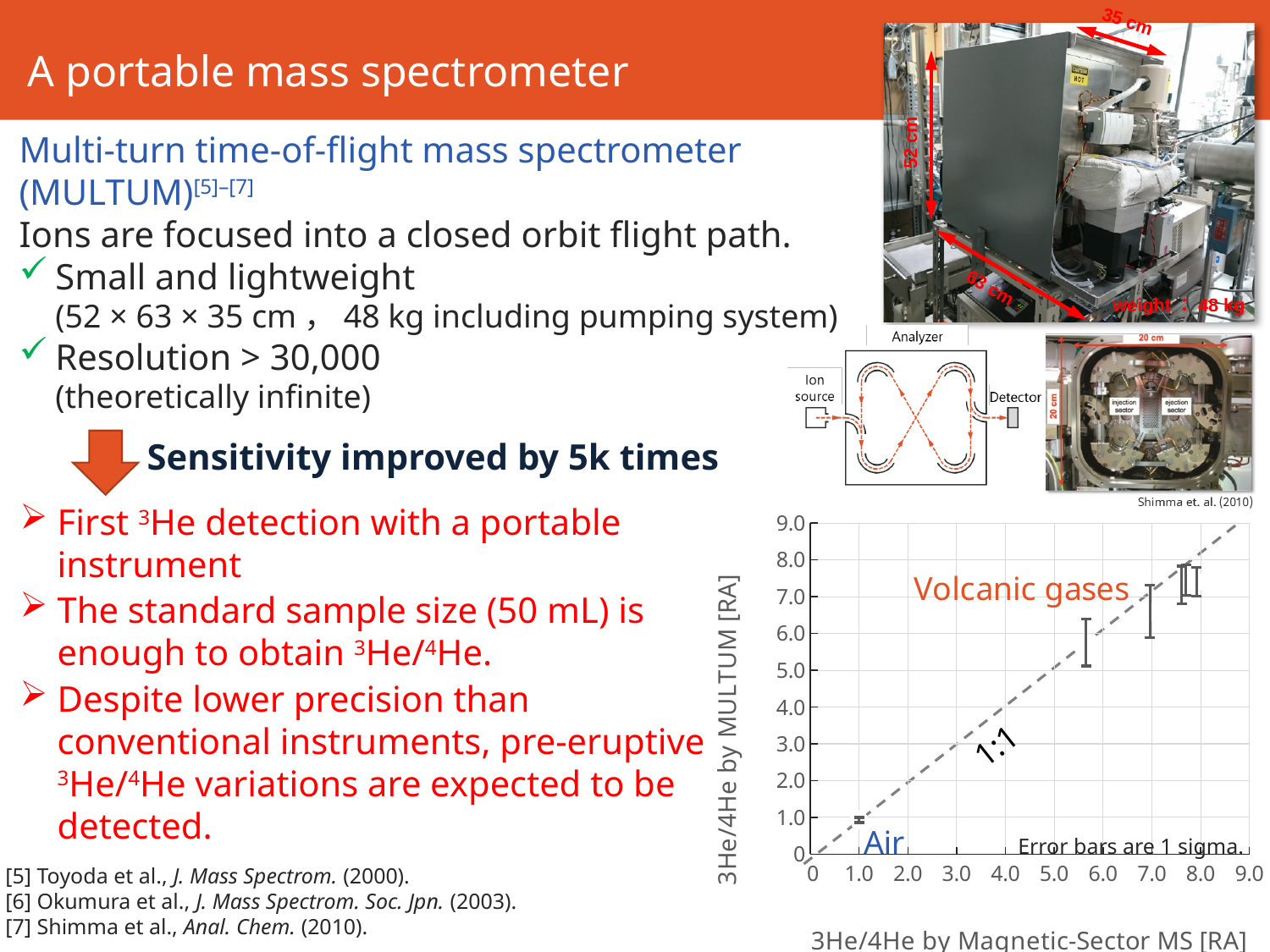
Which sample group has the higher 3He/4He values, Air or Volcanic gases? Volcanic gases What kind of chart is shown at the bottom right of the slide? scatter chart What is the label of the x axis of the chart? 3He/4He by Magnetic-Sector MS [RA] Do the MULTUM values rise or fall as the Magnetic-Sector MS values increase along the x axis? rise Are the Magnetic-Sector MS values for the volcanic gas samples greater or less than 4.0? greater Are the MULTUM values for the volcanic gas samples greater or less than 5.0? greater What is the maximum value shown on the y axis of the chart? 9.0 Is the MULTUM value for the Air sample greater or less than 2.0? less What is the label of the y axis of the chart? 3He/4He by MULTUM [RA] What ratio does the dashed line in the chart represent? 1:1